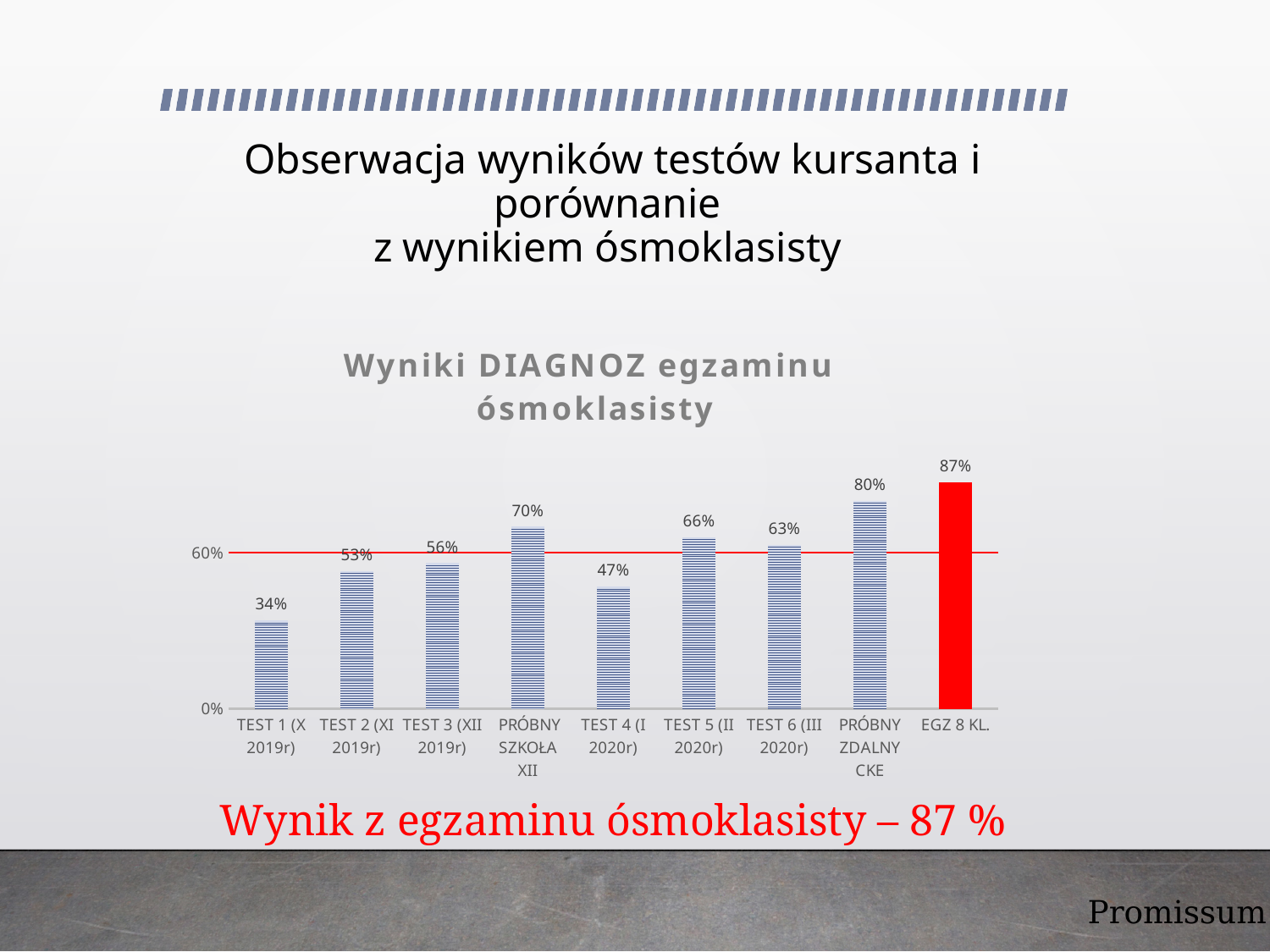
How many categories are shown on the x axis? 9 Which is larger, the value for TEST 5 (II 2020r) or TEST 6 (III 2020r)? TEST 5 (II 2020r) What is the value for TEST 1 (X 2019r)? 34% What is the value for EGZ 8 KL.? 87% What is the value for TEST 4 (I 2020r)? 47% What kind of chart is shown on the slide? bar chart What is the title of the chart? Wyniki DIAGNOZ egzaminu ósmoklasisty What is the value for PRÓBNY SZKOŁA XII? 70% Is the value for TEST 2 (XI 2019r) greater or less than 60%? less Which category has the lowest value? TEST 1 (X 2019r) Which category has the highest value? EGZ 8 KL. What is the difference between the values for EGZ 8 KL. and TEST 1 (X 2019r)? 53%